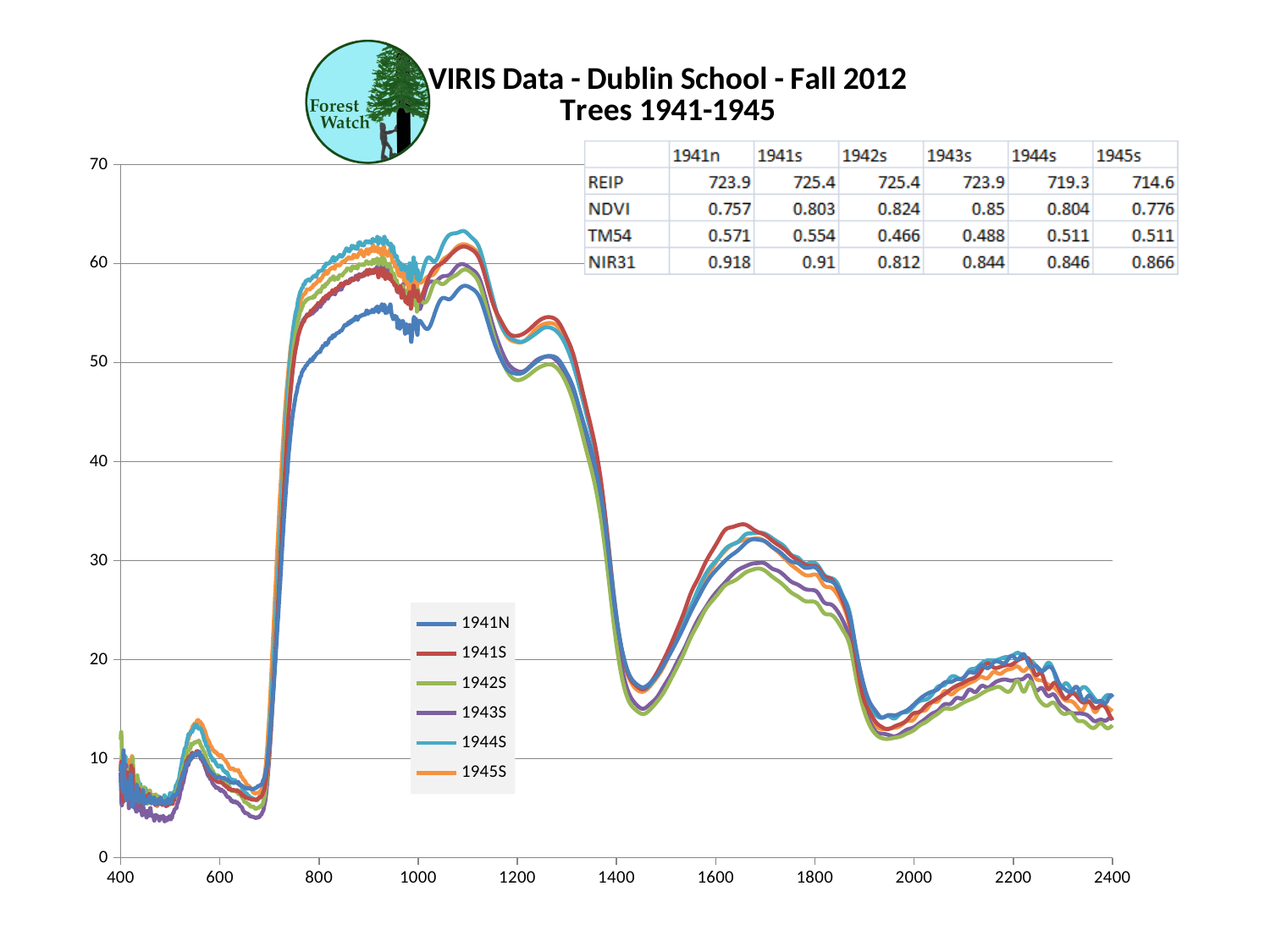
Which series are listed in the legend? 1941N, 1941S, 1942S, 1943S, 1944S, 1945S Is the value for 1941S at x = 1650 greater or less than 30? greater Is the value for 1941N at x = 900 greater or less than 60? less Is the value for 1943S at x = 1800 greater or less than 30? less What is the range of the x axis? 400 to 2400 How many series does the legend list? 6 Between x = 1100 and x = 1450, do the values rise or fall? fall What kind of chart is shown on the slide? line chart Which series has the lowest value at x = 900? 1941N At x = 900, which is larger, 1941N or 1944S? 1944S